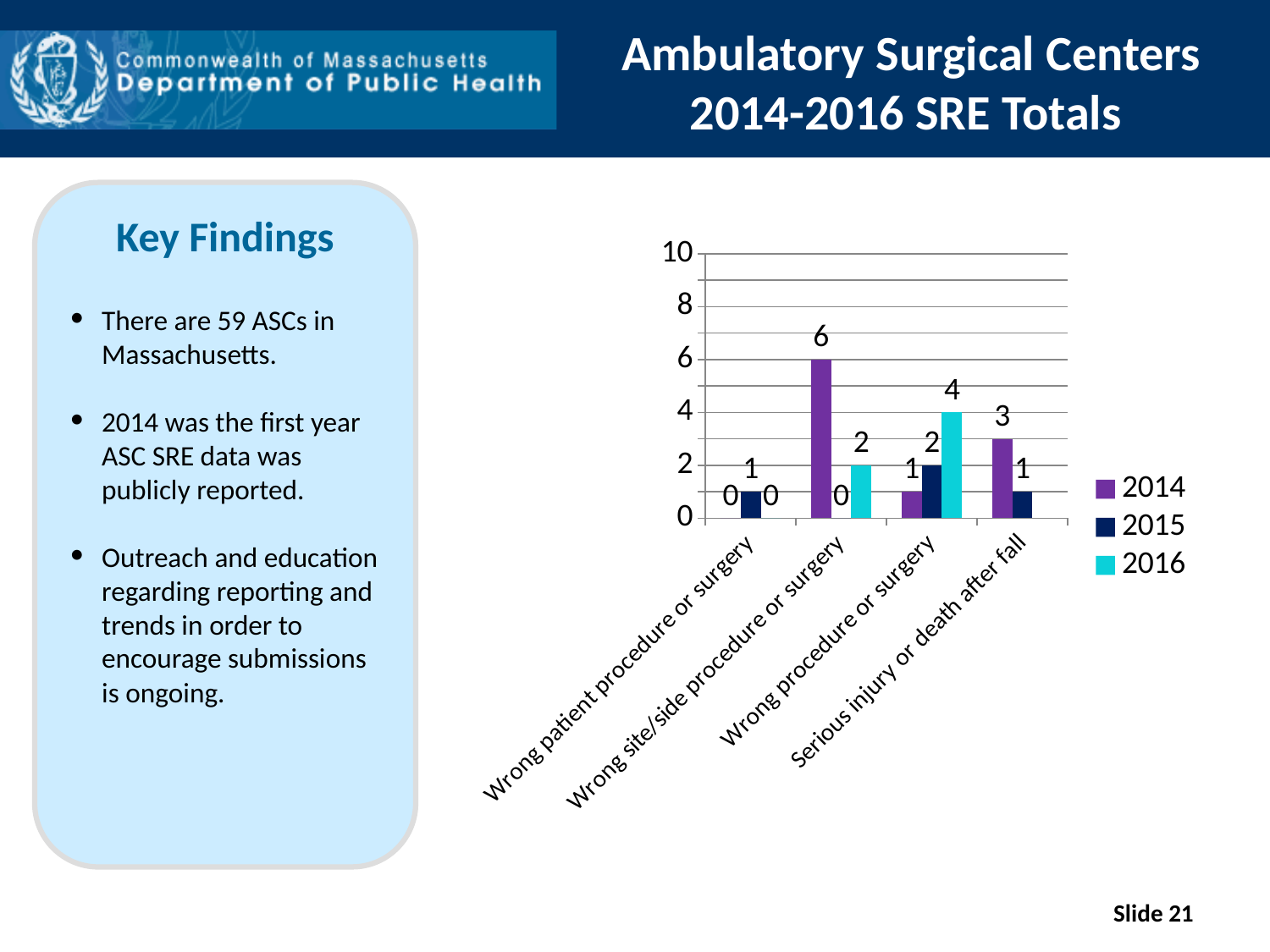
What is the 2014 value for Serious injury or death after fall? 3 What kind of chart is shown on the slide? bar chart Which is larger for Wrong procedure or surgery: the 2015 value or the 2016 value? 2016 What is the difference between the 2014 and 2016 values for Wrong site/side procedure or surgery? 4 Which category has the highest 2016 value? Wrong procedure or surgery Which category has the highest 2014 value? Wrong site/side procedure or surgery How many series does the chart legend list? 3 What is the 2014 value for Wrong site/side procedure or surgery? 6 What is the 2016 value for Wrong procedure or surgery? 4 What is the 2015 value for Wrong patient procedure or surgery? 1 How many categories are shown on the x axis of the chart? 4 Which year is shown in purple in the chart legend? 2014